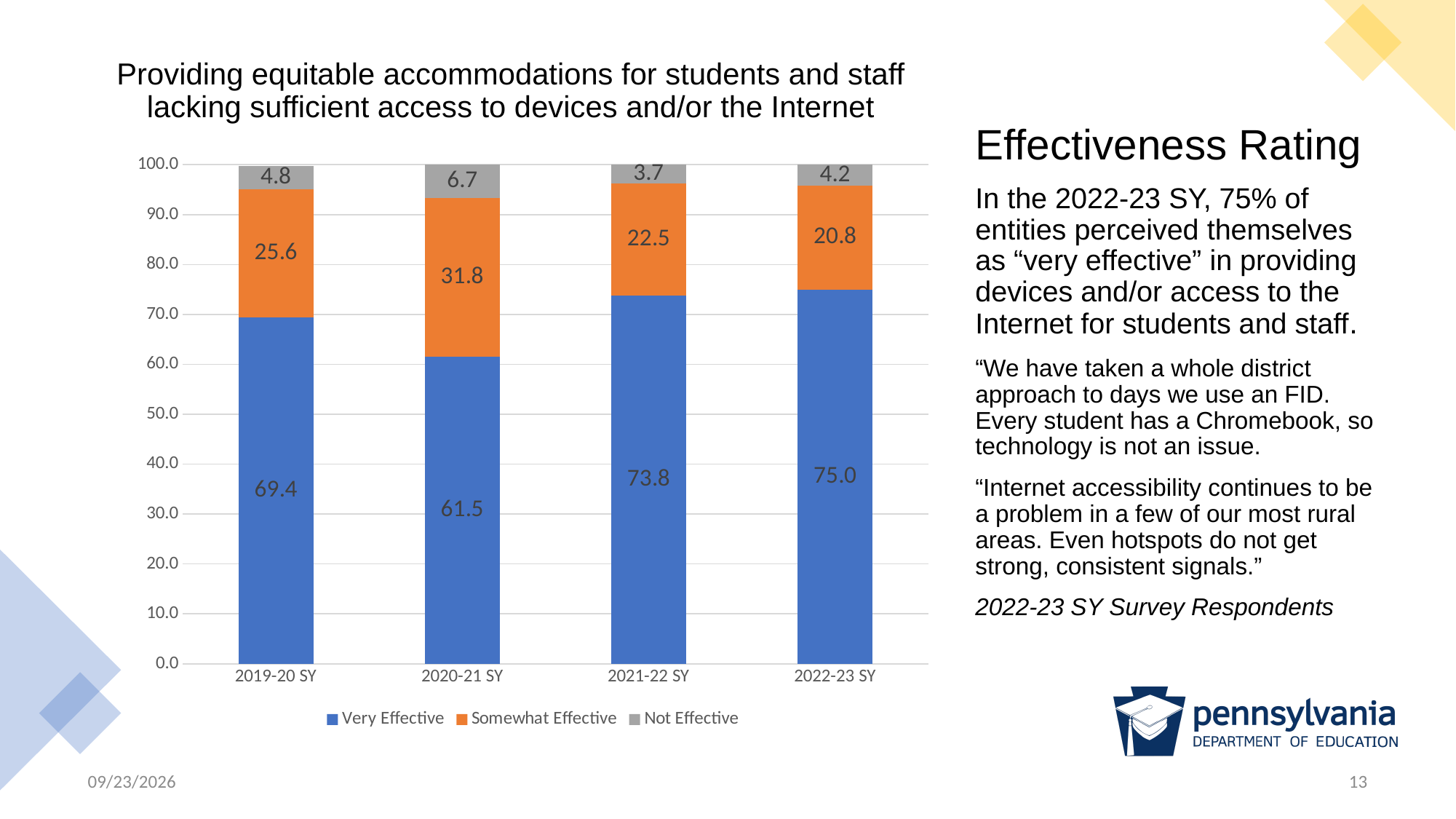
Which school year has the highest Not Effective value? 2020-21 SY What is the difference between the Very Effective values for 2022-23 SY and 2019-20 SY? 5.6 What kind of chart is shown on the slide? Stacked bar chart How many series does the legend list? 3 What is the total of the stacked bar for 2021-22 SY? 100.0 How many school years are shown on the x axis? 4 Which is larger, the Somewhat Effective value for 2019-20 SY or for 2021-22 SY? 2019-20 SY What is the Not Effective value for 2021-22 SY? 3.7 What is the Very Effective value for 2022-23 SY? 75.0 What is the Somewhat Effective value for 2020-21 SY? 31.8 Which school year has the highest Very Effective value? 2022-23 SY Which school year has the lowest Very Effective value? 2020-21 SY